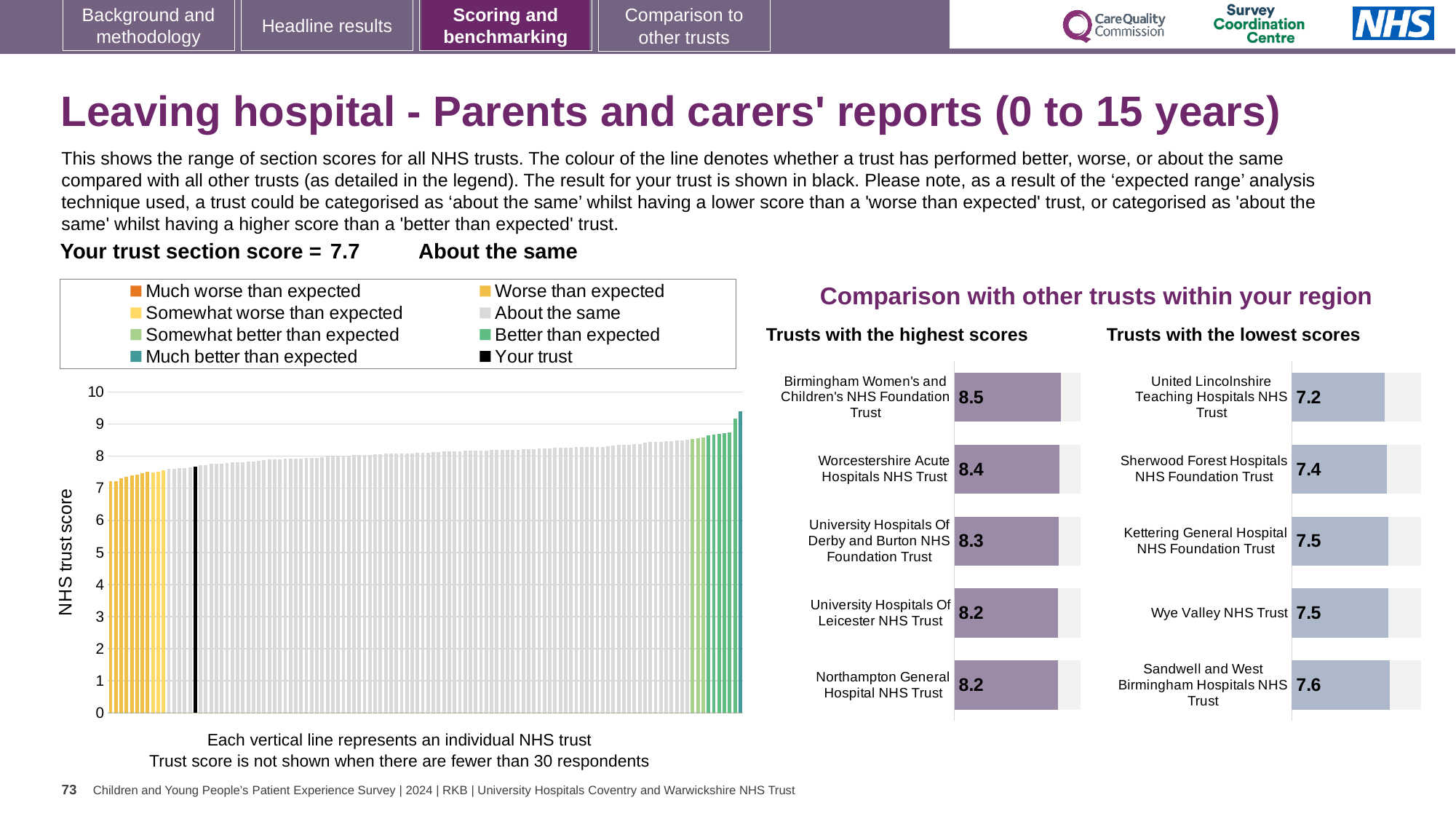
In the 'Trusts with the lowest scores' chart, which has the larger score: Kettering General Hospital NHS Foundation Trust or Sandwell and West Birmingham Hospitals NHS Trust? Sandwell and West Birmingham Hospitals NHS Trust In the 'Trusts with the highest scores' chart, which trust has the highest score? Birmingham Women's and Children's NHS Foundation Trust How many entries does the legend of the NHS trust score chart list? 8 In the 'Trusts with the lowest scores' chart, which trust has the lowest score? United Lincolnshire Teaching Hospitals NHS Trust In the 'Trusts with the lowest scores' chart, what is the score for Sherwood Forest Hospitals NHS Foundation Trust? 7.4 What kind of chart is the large 'NHS trust score' chart on the left? Bar chart In the 'NHS trust score' chart, do the bar heights rise or fall from left to right? Rise In the 'Trusts with the highest scores' chart, what is the score for Birmingham Women's and Children's NHS Foundation Trust? 8.5 In the 'NHS trust score' chart, what colour does the legend use for 'Your trust'? Black In the 'NHS trust score' chart, is the value of the black 'Your trust' bar greater or less than 8? less In the 'Trusts with the highest scores' chart, what is the difference between the scores of Birmingham Women's and Children's NHS Foundation Trust and Northampton General Hospital NHS Trust? 0.3 How many trusts are shown in the 'Trusts with the lowest scores' chart? 5